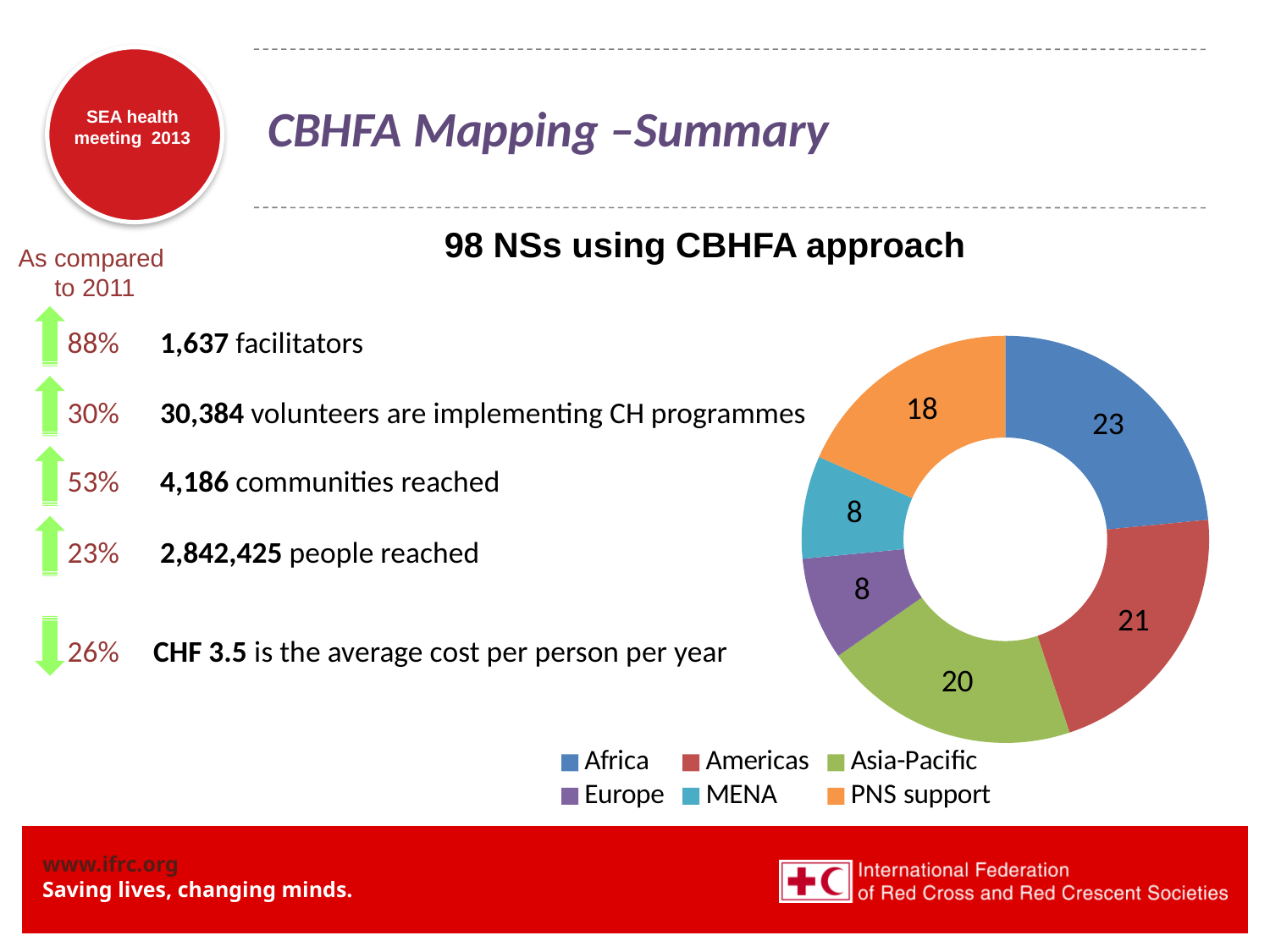
Which category has the highest value in the doughnut chart? Africa What is the total of all the values shown in the doughnut chart? 98 What is the difference between the values for Africa and Americas in the doughnut chart? 2 What value is shown for MENA in the doughnut chart? 8 What type of chart is shown on the slide? Doughnut (pie) chart What value is shown for Asia-Pacific in the doughnut chart? 20 How many categories are shown in the doughnut chart? 6 What is the difference between the values for Asia-Pacific and Europe in the doughnut chart? 12 What value is shown for Africa in the doughnut chart? 23 Which has a larger value in the doughnut chart, Americas or Asia-Pacific? Americas Which two categories share the lowest value in the doughnut chart? Europe and MENA What value is shown for PNS support in the doughnut chart? 18